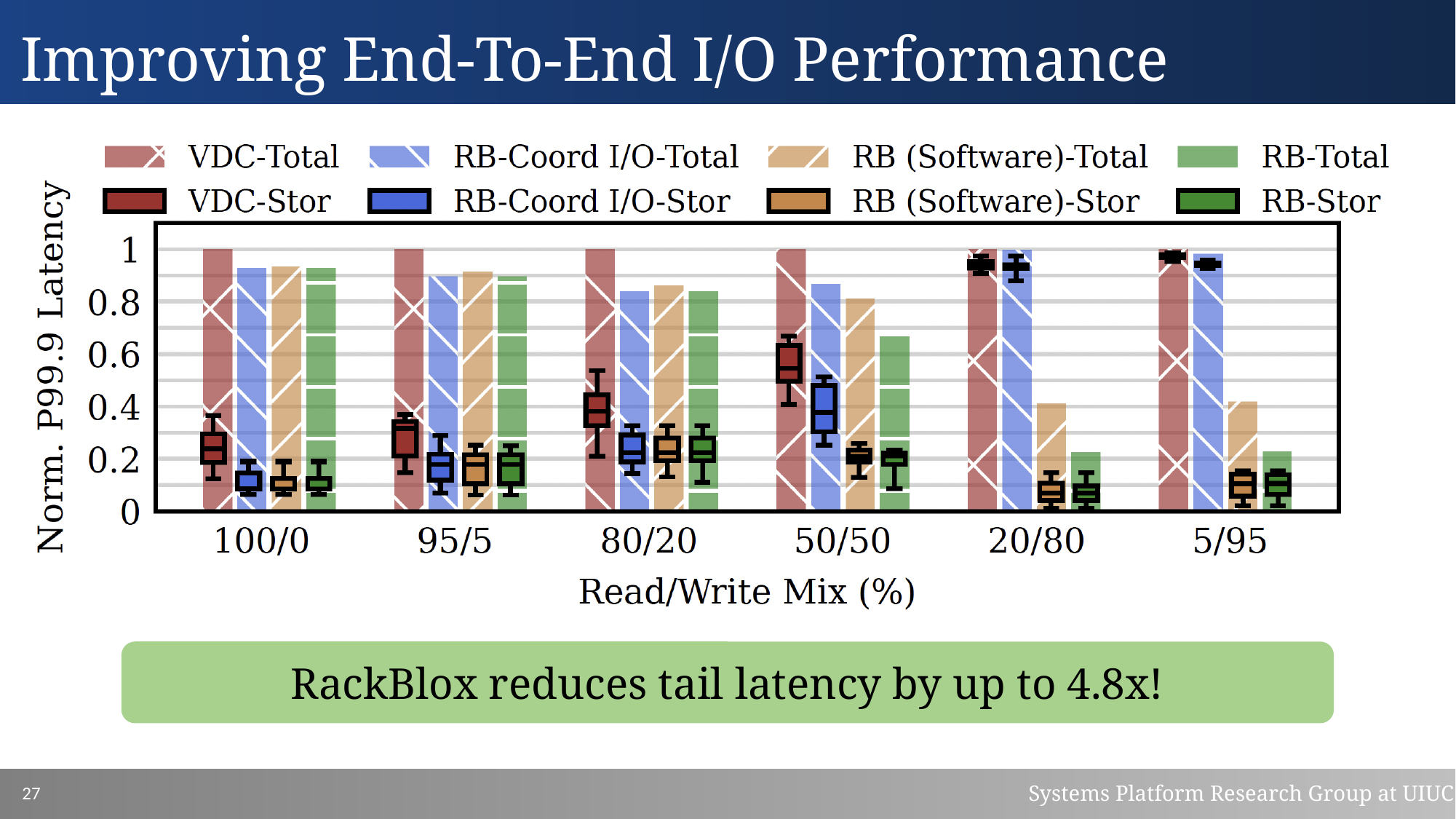
What kind of chart is shown on the slide? bar chart Is the value for RB (Software)-Total at the 5/95 read/write mix greater or less than 0.6? less Which is larger: RB-Total at the 100/0 mix or RB-Total at the 20/80 mix? RB-Total at 100/0 What is the label of the x axis? Read/Write Mix (%) What is the value of VDC-Total at the 100/0 read/write mix? 1 Is the value for RB-Total at the 20/80 read/write mix greater or less than 0.4? less How many series does the legend list? 8 Does the RB-Total value rise or fall as the read/write mix moves from 100/0 to 5/95? fall Is the value for RB-Total at the 50/50 read/write mix greater or less than 0.8? less What is the label of the y axis? Norm. P99.9 Latency How many read/write mix categories are shown on the x axis? 6